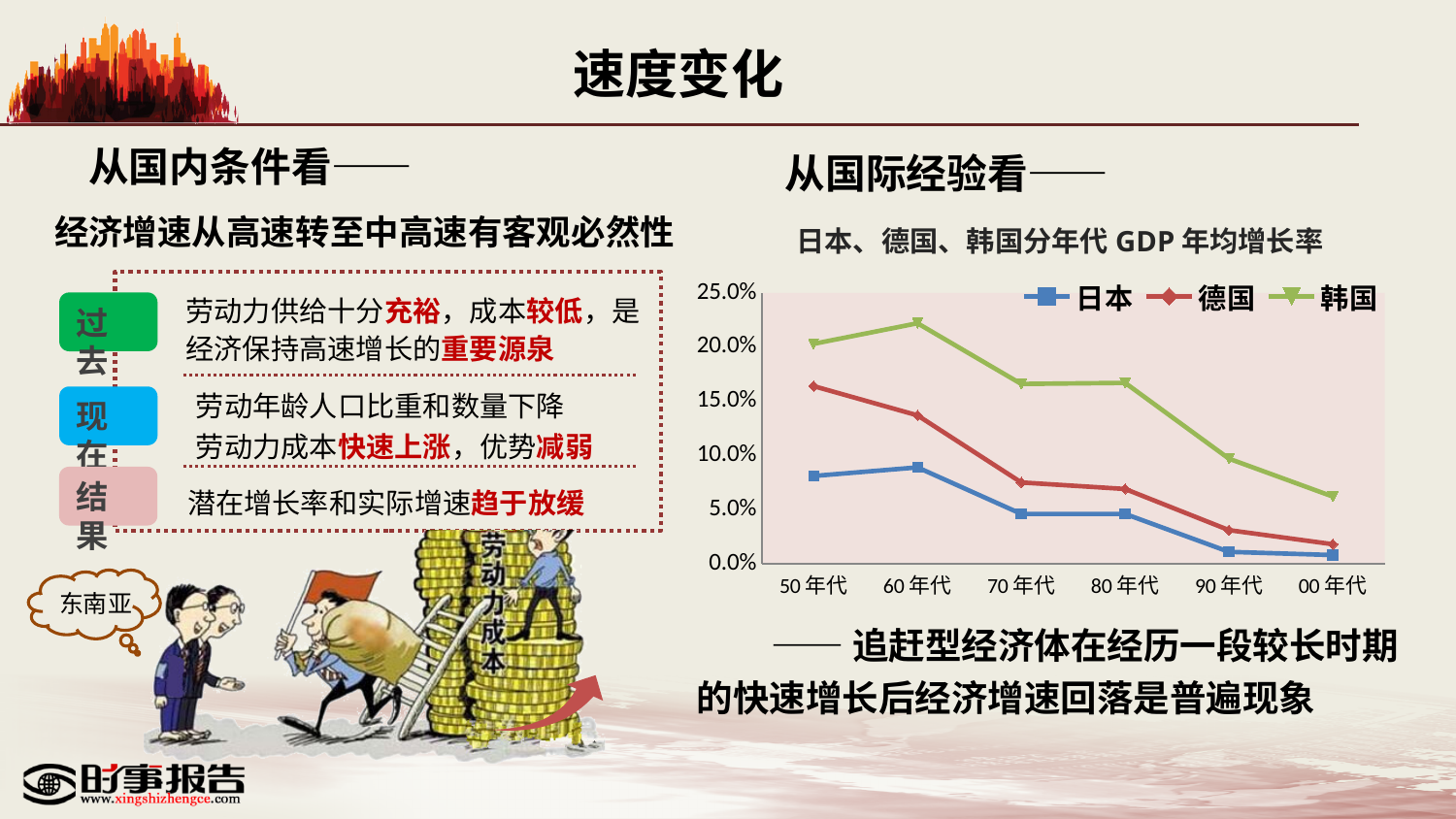
Overall, do the values for 日本 rise or fall from the 50年代 to the 00年代? fall Is the value for 德国 in the 70年代 greater or less than 10.0%? less In which decade does 韩国 reach its highest GDP growth rate in the chart? 60年代 Is the value for 日本 in the 60年代 greater or less than 10.0%? less What is the title of the chart? 日本、德国、韩国分年代 GDP 年均增长率 How many series does the legend of the chart list? 3 In the 70年代, which is larger: the value for 德国 or the value for 日本? 德国 What kind of chart is shown on the slide? line chart Which country has the highest value in the 50年代 in the chart? 韩国 Is the value for 韩国 in the 50年代 greater or less than 15.0%? greater How many decades (categories) are shown on the x axis of the chart? 6 In which decade is the value for 日本 lowest in the chart? 00年代